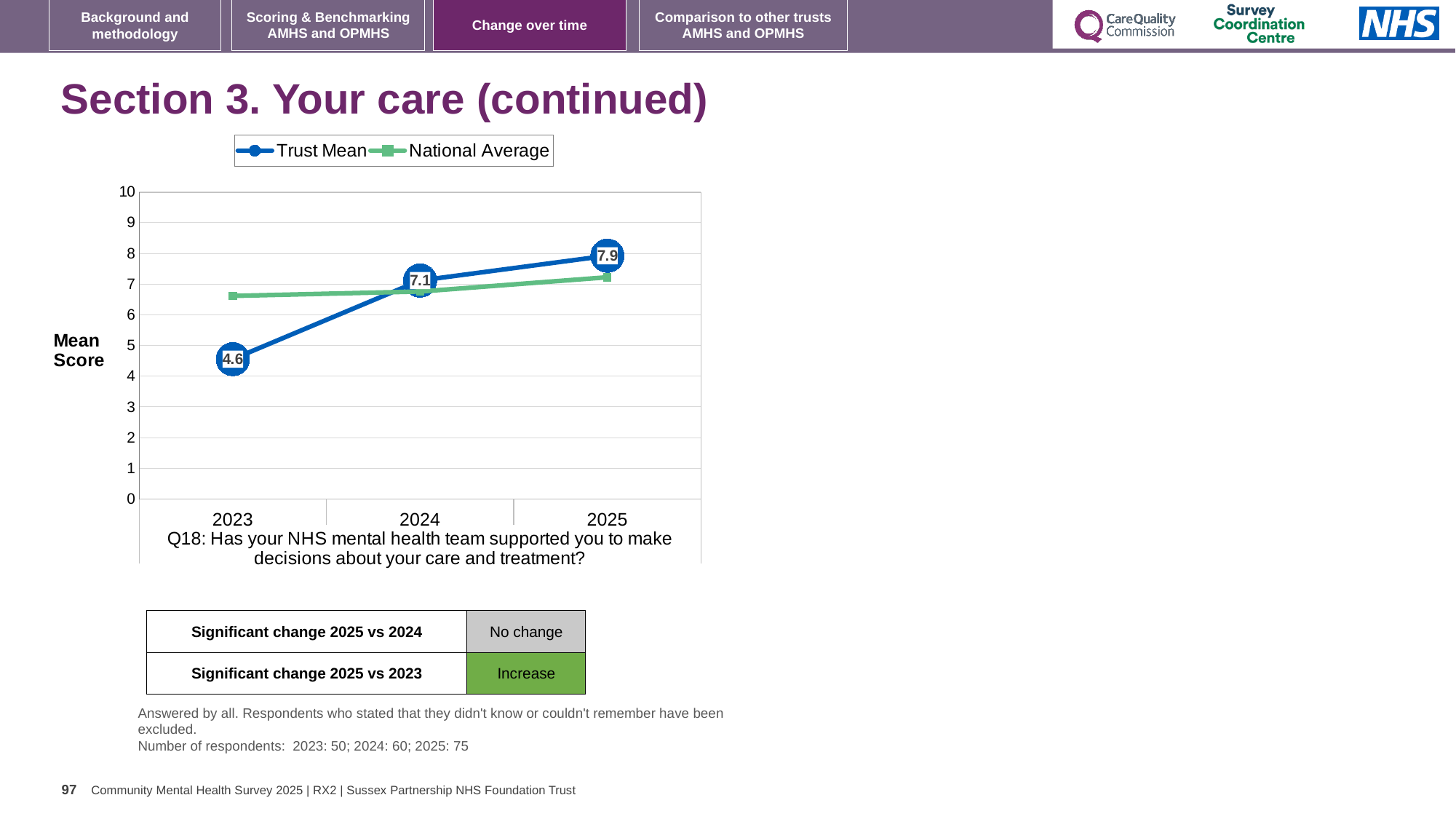
In which year is the Trust Mean score highest? 2025 What is the difference between the Trust Mean scores for 2024 and 2023? 2.5 In 2025, which is larger: the Trust Mean or the National Average? Trust Mean What is the Trust Mean score for 2025? 7.9 What is the Trust Mean score for 2023? 4.6 How many series does the legend list? 2 In which year is the Trust Mean score lowest? 2023 What is the Trust Mean score for 2024? 7.1 Does the Trust Mean rise or fall from 2023 to 2025? rise Is the National Average for 2023 greater or less than 6? greater In 2023, which is larger: the Trust Mean or the National Average? National Average What is the difference between the Trust Mean scores for 2025 and 2023? 3.3